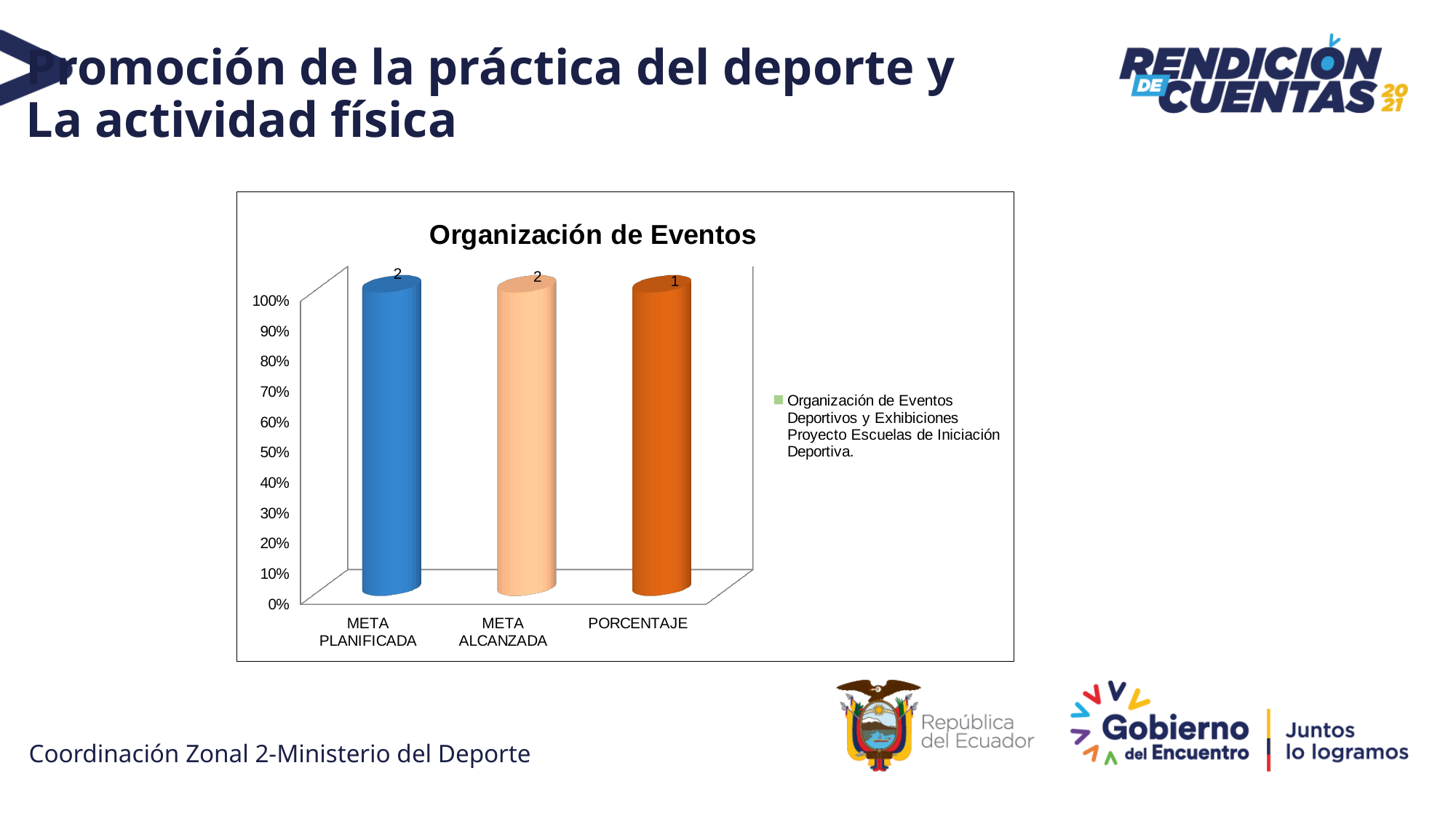
How many series does the legend list? 1 What is the data label shown on the META ALCANZADA bar? 2 What is the legend entry of the chart? Organización de Eventos Deportivos y Exhibiciones Proyecto Escuelas de Iniciación Deportiva. What is the data label shown on the PORCENTAJE bar? 1 How many categories are shown on the x axis of the chart? 3 What is the title of the chart? Organización de Eventos What is the highest tick value shown on the y axis? 100% What kind of chart is shown on the slide? Bar chart What is the data label shown on the META PLANIFICADA bar? 2